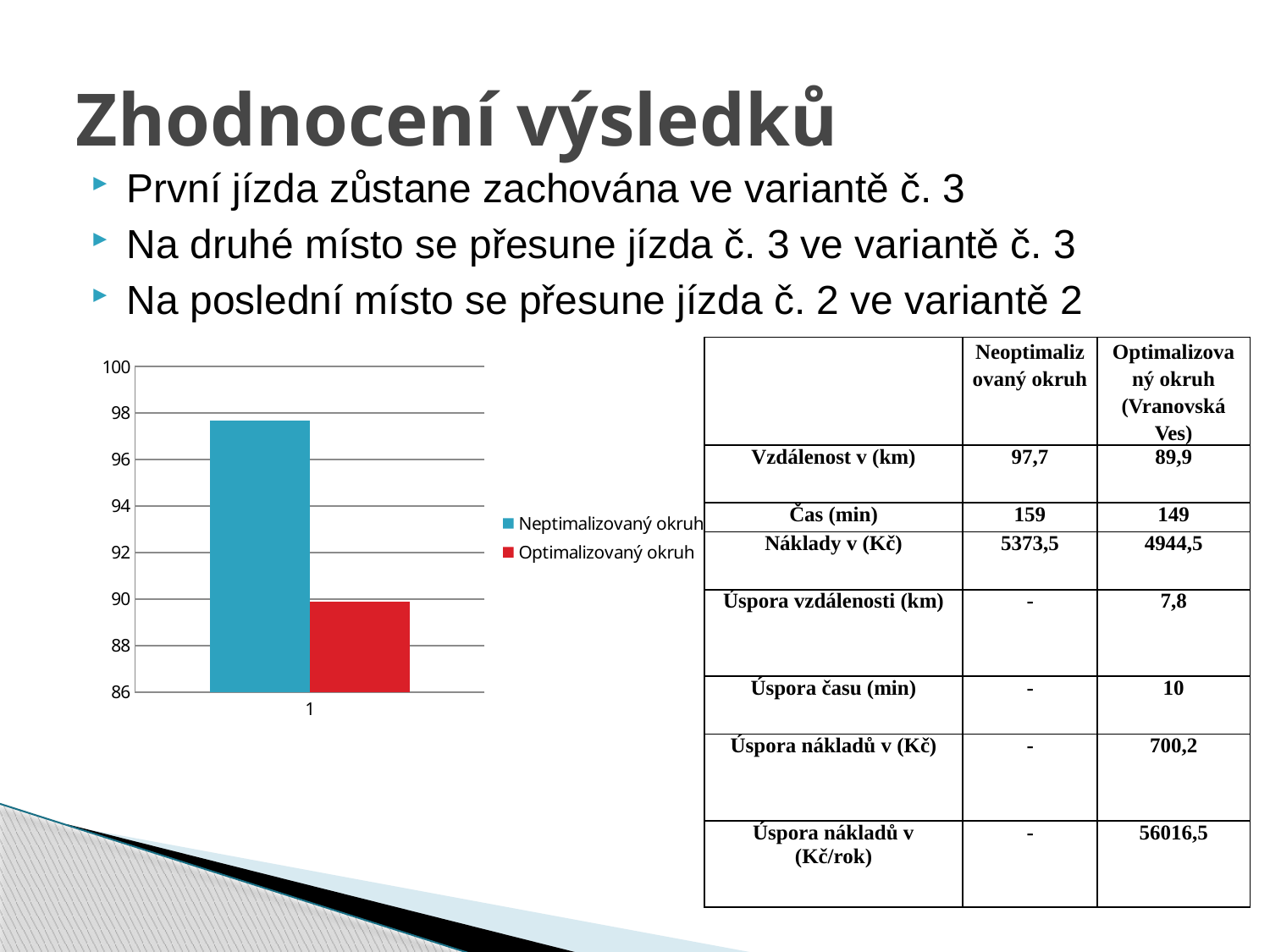
Is the value for Optimalizovaný okruh greater or less than 92? less Which series has the highest bar in the chart? Neptimalizovaný okruh Which series has the taller bar, Neptimalizovaný okruh or Optimalizovaný okruh? Neptimalizovaný okruh Is the value for Neptimalizovaný okruh greater or less than 96? greater Is the value for Optimalizovaný okruh greater or less than 94? less What colour is the bar for Neptimalizovaný okruh? blue Which series has the lowest bar in the chart? Optimalizovaný okruh How many categories are shown on the x axis of the chart? 1 What is the lowest value shown on the chart's y axis? 86 What kind of chart is shown on the slide? bar chart How many series does the chart legend list? 2